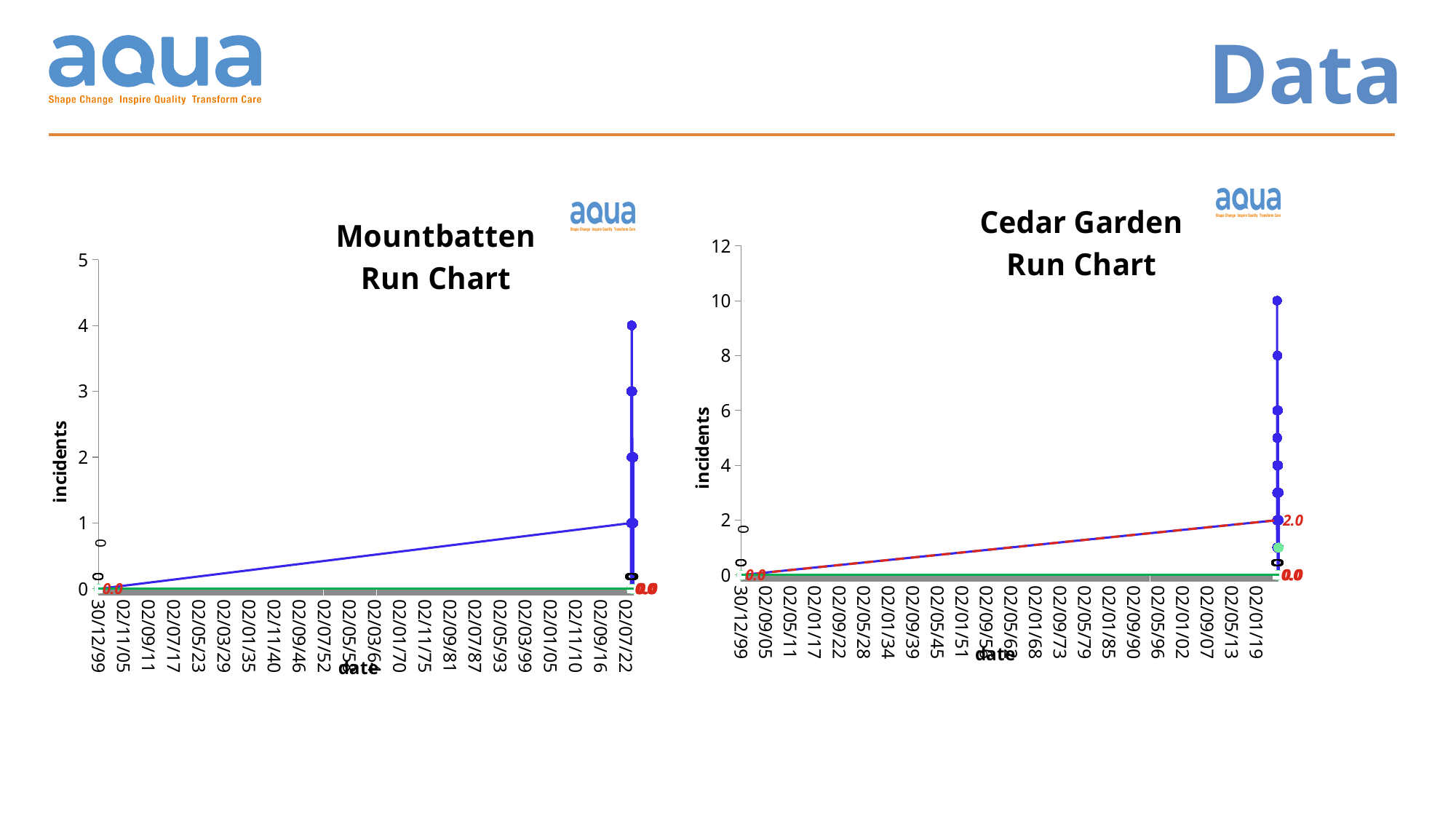
Which chart reaches a higher peak number of incidents, Mountbatten or Cedar Garden? Cedar Garden On the Mountbatten Run Chart, is the highest plotted point greater or less than 3? greater What is the label on the y axis of the Mountbatten Run Chart? incidents What is the highest tick value on the y axis of the Cedar Garden Run Chart? 12 On the Cedar Garden Run Chart, is the highest plotted point greater or less than 8? greater On the Cedar Garden Run Chart, what is the highest value reached by the plotted points? 10 On the Cedar Garden Run Chart, what value is printed in red next to the point at the right end of the dashed line? 2.0 On the Mountbatten Run Chart, what is the highest value reached by the plotted points? 4 What kind of chart is the Mountbatten Run Chart? line chart On the Mountbatten Run Chart, what value is printed in red at the left end of the green line? 0.0 What kind of chart is the Cedar Garden Run Chart? line chart